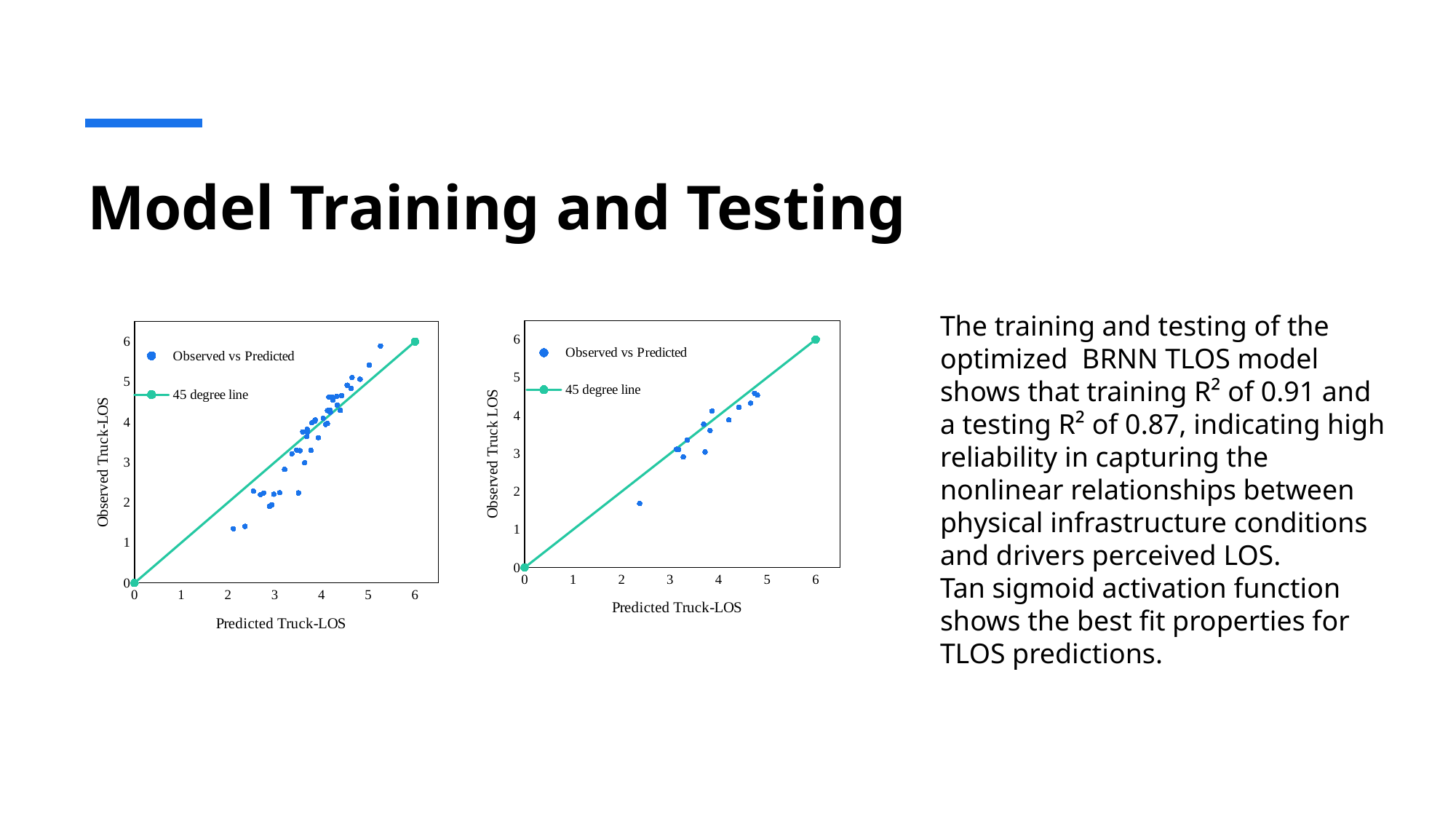
In the left chart, is the highest Observed vs Predicted point greater or less than 5 on the Observed Truck-LOS axis? greater In the right chart, what is the label of the x axis? Predicted Truck-LOS In the left chart, what are the two legend entries? Observed vs Predicted; 45 degree line In the right chart, is the highest Observed vs Predicted point greater or less than 5 on the Observed Truck LOS axis? less In the right chart, do the Observed vs Predicted points generally rise or fall as Predicted Truck-LOS increases? rise What kind of chart is the right chart on the slide? scatter chart In the right chart, is the lowest Observed vs Predicted point greater or less than 2 on the Observed Truck LOS axis? less What kind of chart is the left chart on the slide? scatter chart In the right chart, what is the Observed Truck LOS value of the 45 degree line at a Predicted Truck-LOS of 0? 0 In the left chart, what is the Observed Truck-LOS value of the 45 degree line at a Predicted Truck-LOS of 6? 6 How many series does the legend of the left chart list? 2